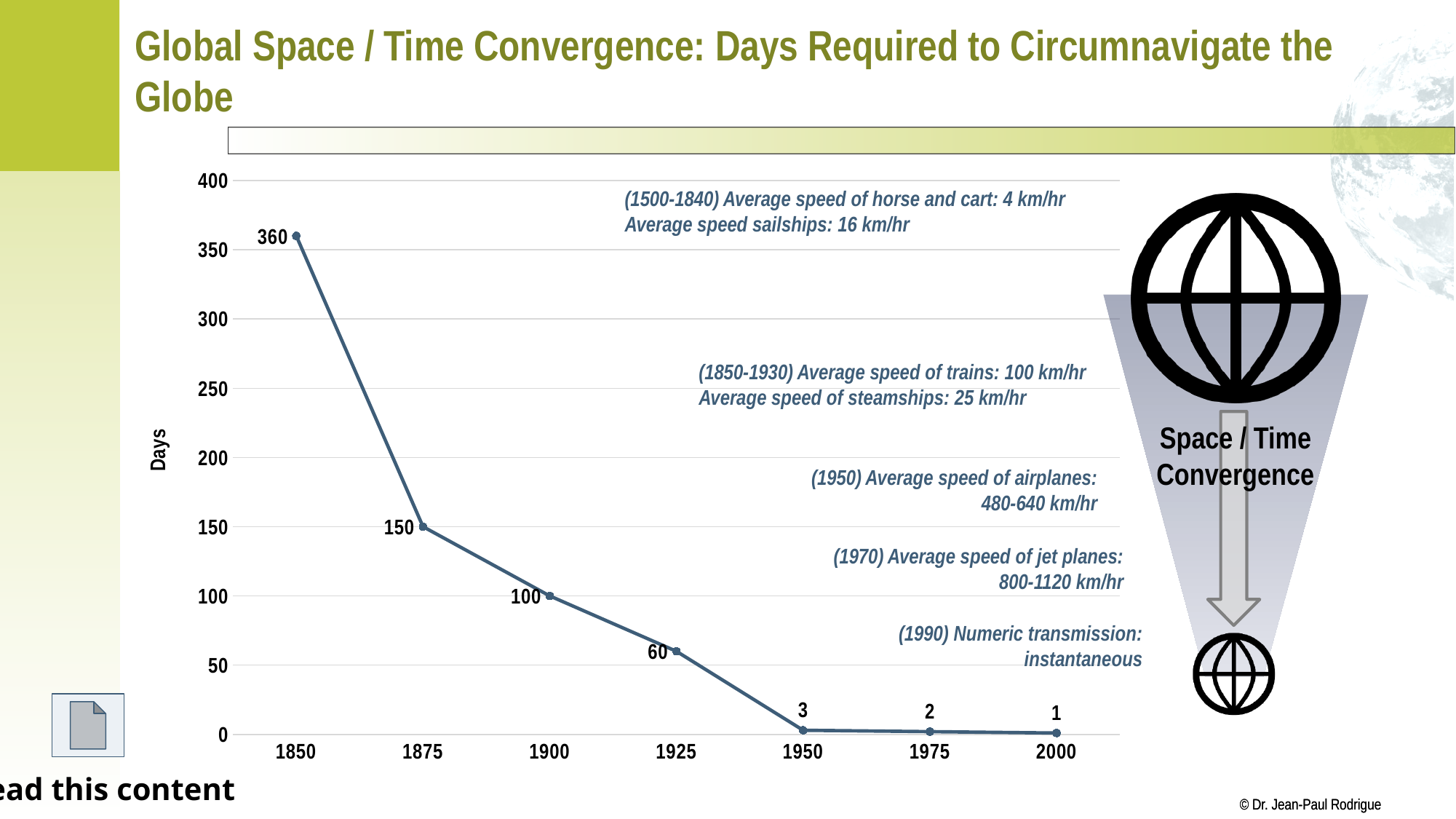
How many days were required to circumnavigate the globe in 1850? 360 How many days are shown for 1975? 2 Which year has the highest number of days? 1850 Which year has the lowest number of days? 2000 Which is larger, the value for 1875 or the value for 1900? 1875 What is the difference in days between 1850 and 1875? 210 What is the label on the vertical axis of the chart? Days What is the value plotted for 1925? 60 What is the difference in days between 1900 and 1925? 40 How many data points are plotted on the chart? 7 Do the values rise or fall from 1850 to 2000? Fall What kind of chart is shown on the slide? Line chart